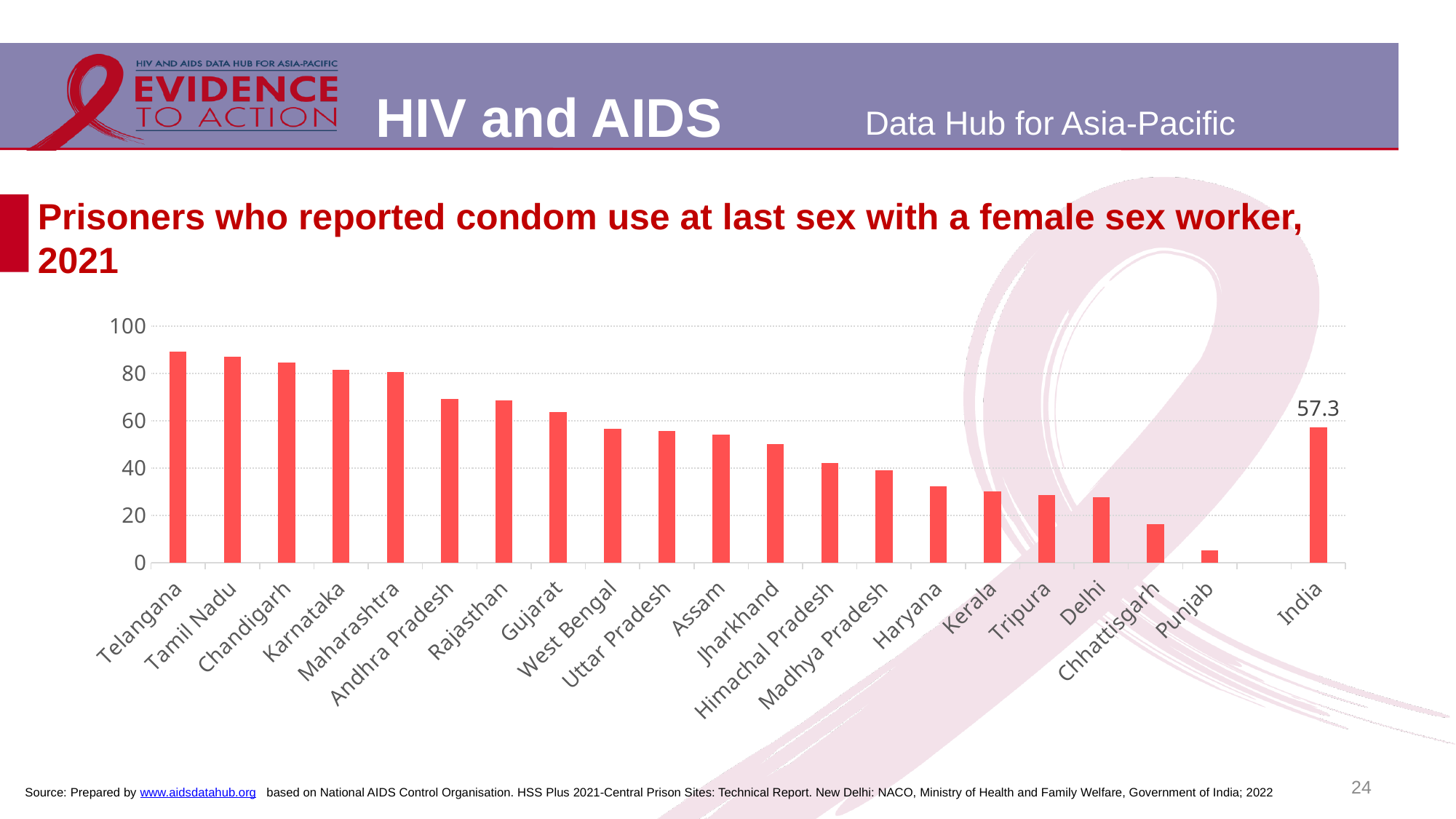
Which has the larger value, Karnataka or Kerala? Karnataka Do the values for the states and union territories rise or fall from left to right, before the India bar? Fall Is the value for Punjab greater or less than 20? less Which has the larger value, Assam or Delhi? Assam Is the value for Andhra Pradesh greater or less than 60? greater Is the value for Kerala greater or less than 20? greater What is the value for India? 57.3 Which state or union territory has the lowest value? Punjab How many categories are plotted on the x axis? 21 What kind of chart is shown on the slide? Bar chart